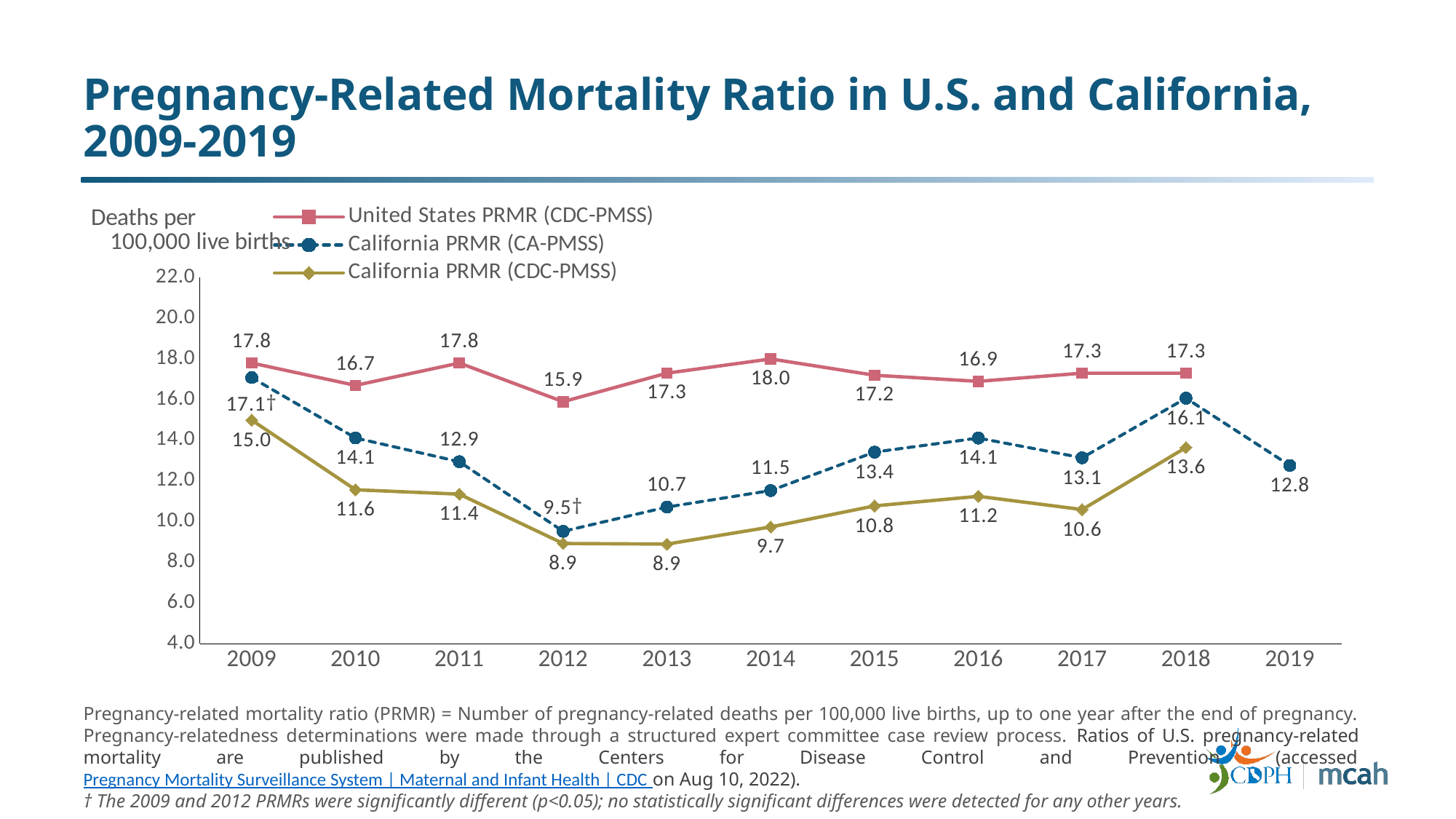
Did the California PRMR (CDC-PMSS) rise or fall from 2009 to 2012? Fall In which year is the California PRMR (CA-PMSS) highest? 2009 How many series does the legend list? 3 What kind of chart is this? Line chart What is the California PRMR (CDC-PMSS) value for 2018? 13.6 How many years are shown on the x axis? 11 Which is larger in 2016: the California PRMR (CA-PMSS) or the California PRMR (CDC-PMSS)? California PRMR (CA-PMSS) In which year is the United States PRMR (CDC-PMSS) lowest? 2012 What unit is given for the y axis? Deaths per 100,000 live births What is the difference between the United States PRMR (CDC-PMSS) and the California PRMR (CA-PMSS) in 2012? 6.4 What is the California PRMR (CA-PMSS) value for 2019? 12.8 What is the United States PRMR (CDC-PMSS) value for 2014? 18.0